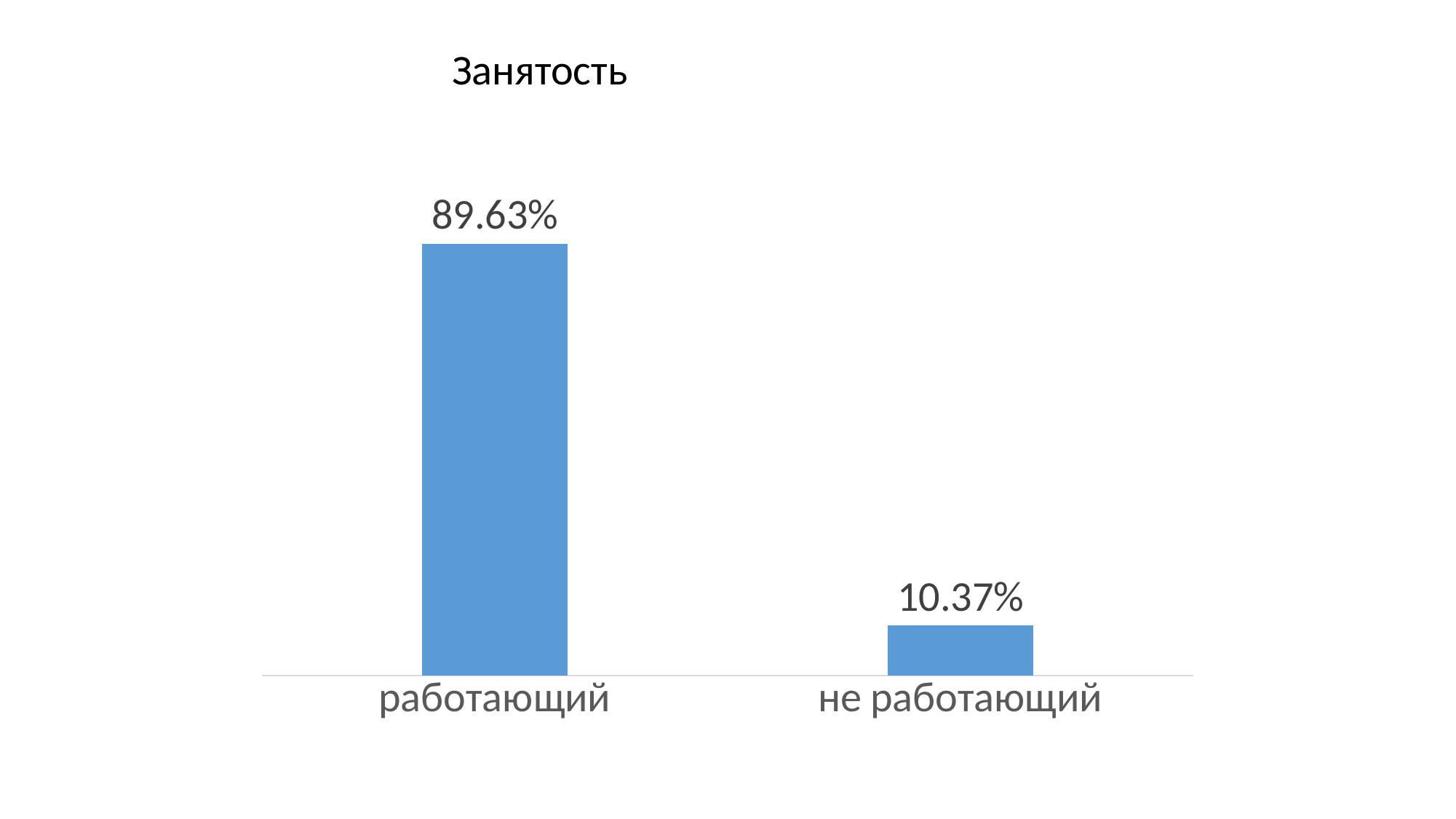
Do the values rise or fall from left to right along the x axis? fall What is the value for работающий? 89.63% Which is larger, the value for работающий or the value for не работающий? работающий What kind of chart is shown on the slide? bar chart What colour are the bars in the chart? blue What is the total of the two values shown in the chart? 100.00% How many categories are shown in the chart? 2 What is the value for не работающий? 10.37% Which category has the highest value? работающий Which category has the lowest value? не работающий What is the difference between the values for работающий and не работающий? 79.26% What is the title of the chart? Занятость